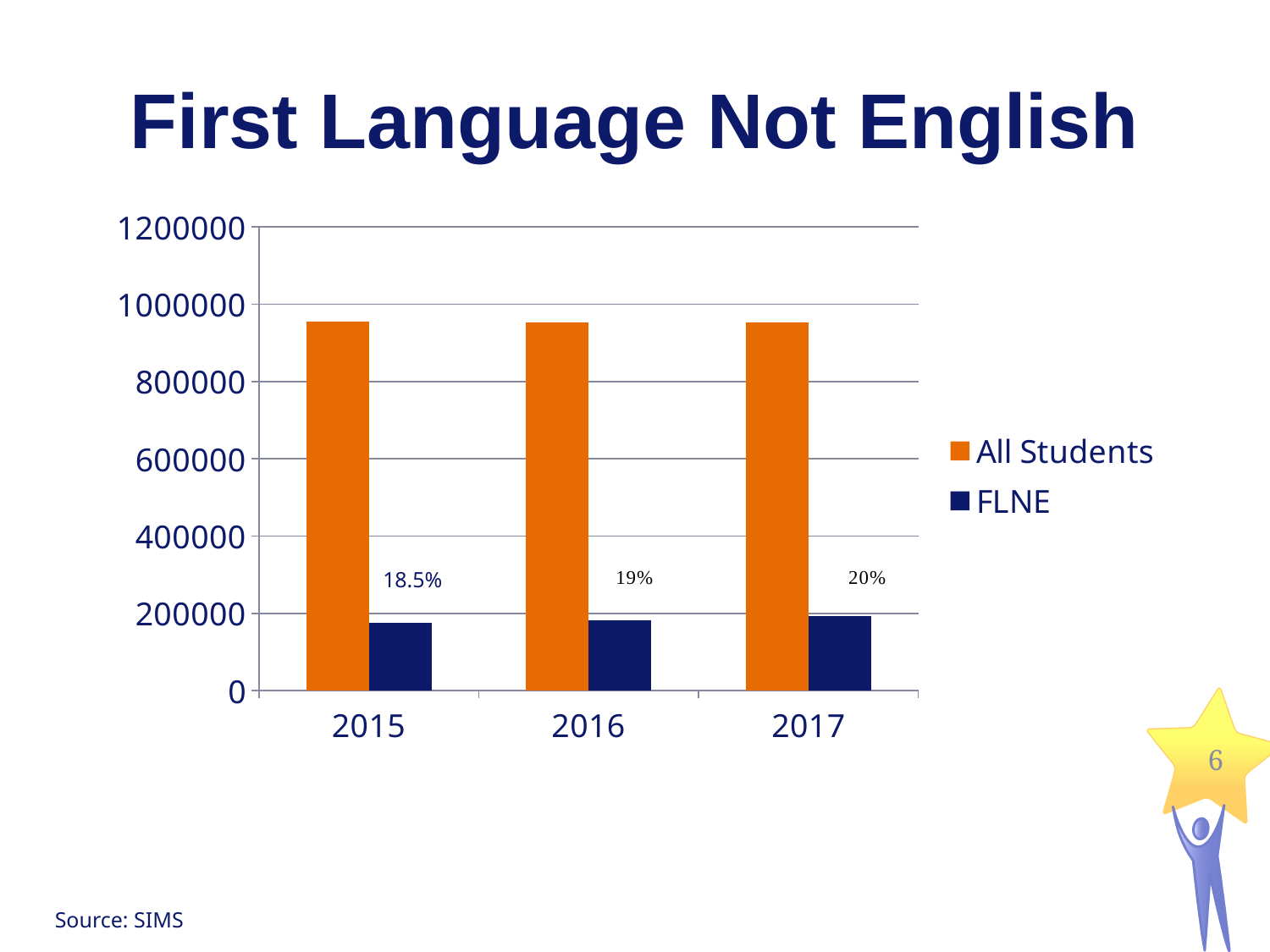
What kind of chart is shown on the slide? bar chart Is the value for FLNE in 2015 greater or less than 200000? less What is the title of the chart? First Language Not English What percentage label is shown for 2015? 18.5% What percentage label is shown for 2017? 20% Is the value for All Students in 2015 greater or less than 800000? greater How many series does the legend list? 2 Is the value for All Students in 2016 greater or less than 1000000? less Do the percentage labels rise or fall from 2015 to 2017? rise Which is larger in 2017, All Students or FLNE? All Students Which series is shown in orange? All Students How many years are shown on the x axis? 3